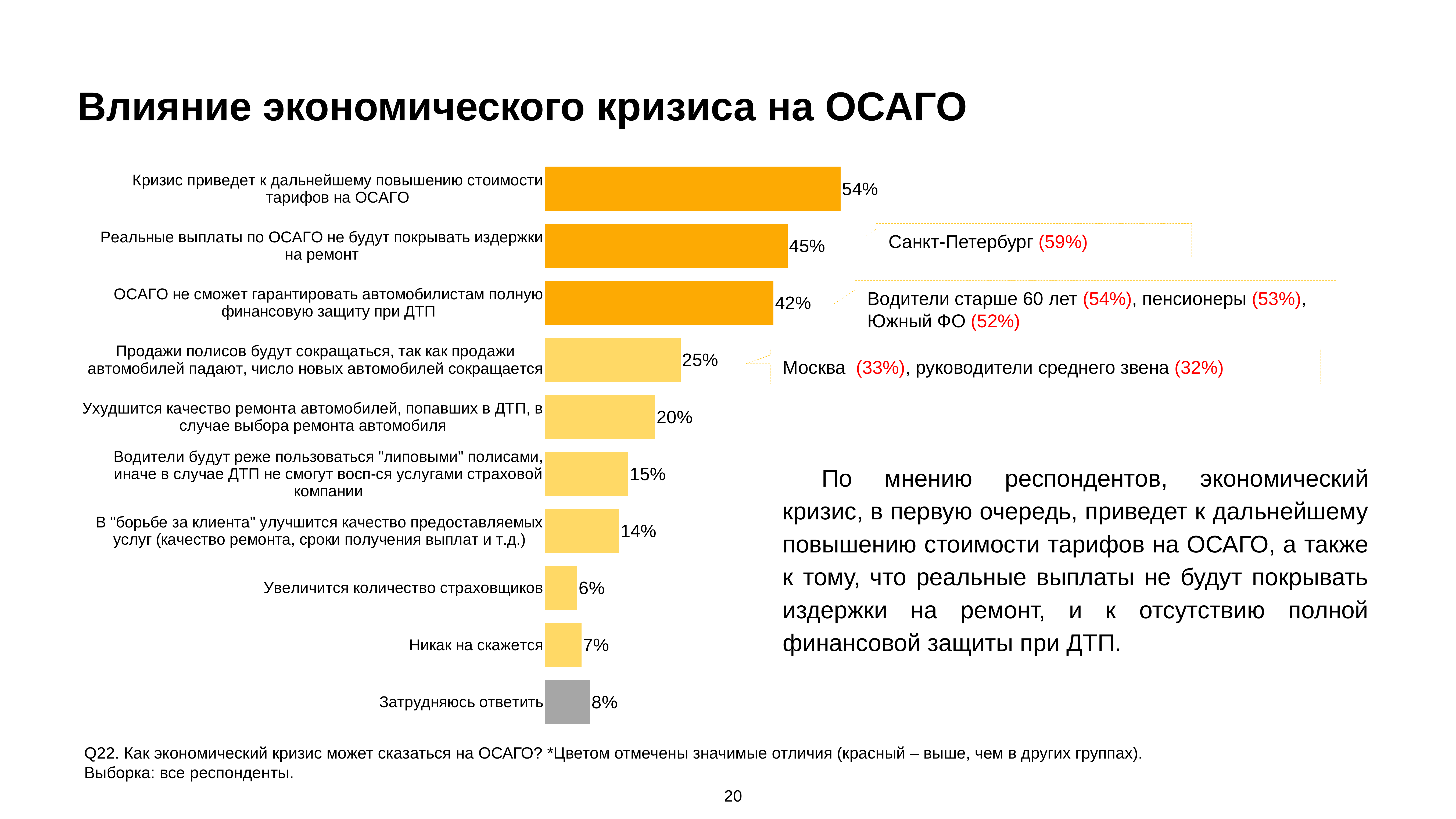
How many categories (bars) are shown in the chart? 10 What kind of chart is shown on the slide? Bar chart Which category has the lowest value in the chart? Увеличится количество страховщиков What is the difference between the highest value (54%) and the value for 'Продажи полисов будут сокращаться, так как продажи автомобилей падают, число новых автомобилей сокращается'? 29% What is the value for 'Затрудняюсь ответить'? 8% What is the difference between the values for 'Реальные выплаты по ОСАГО не будут покрывать издержки на ремонт' and 'ОСАГО не сможет гарантировать автомобилистам полную финансовую защиту при ДТП'? 3% What percentage of respondents said the crisis will lead to a further increase in OSAGO tariffs (Кризис приведет к дальнейшему повышению стоимости тарифов на ОСАГО)? 54% Which is larger: the value for 'Никак на скажется' or the value for 'Увеличится количество страховщиков'? Никак на скажется What is the value for 'Реальные выплаты по ОСАГО не будут покрывать издержки на ремонт'? 45% What is the value for 'Увеличится количество страховщиков'? 6% Which category has the highest value in the chart? Кризис приведет к дальнейшему повышению стоимости тарифов на ОСАГО Which bar in the chart is coloured grey rather than yellow/orange? Затрудняюсь ответить